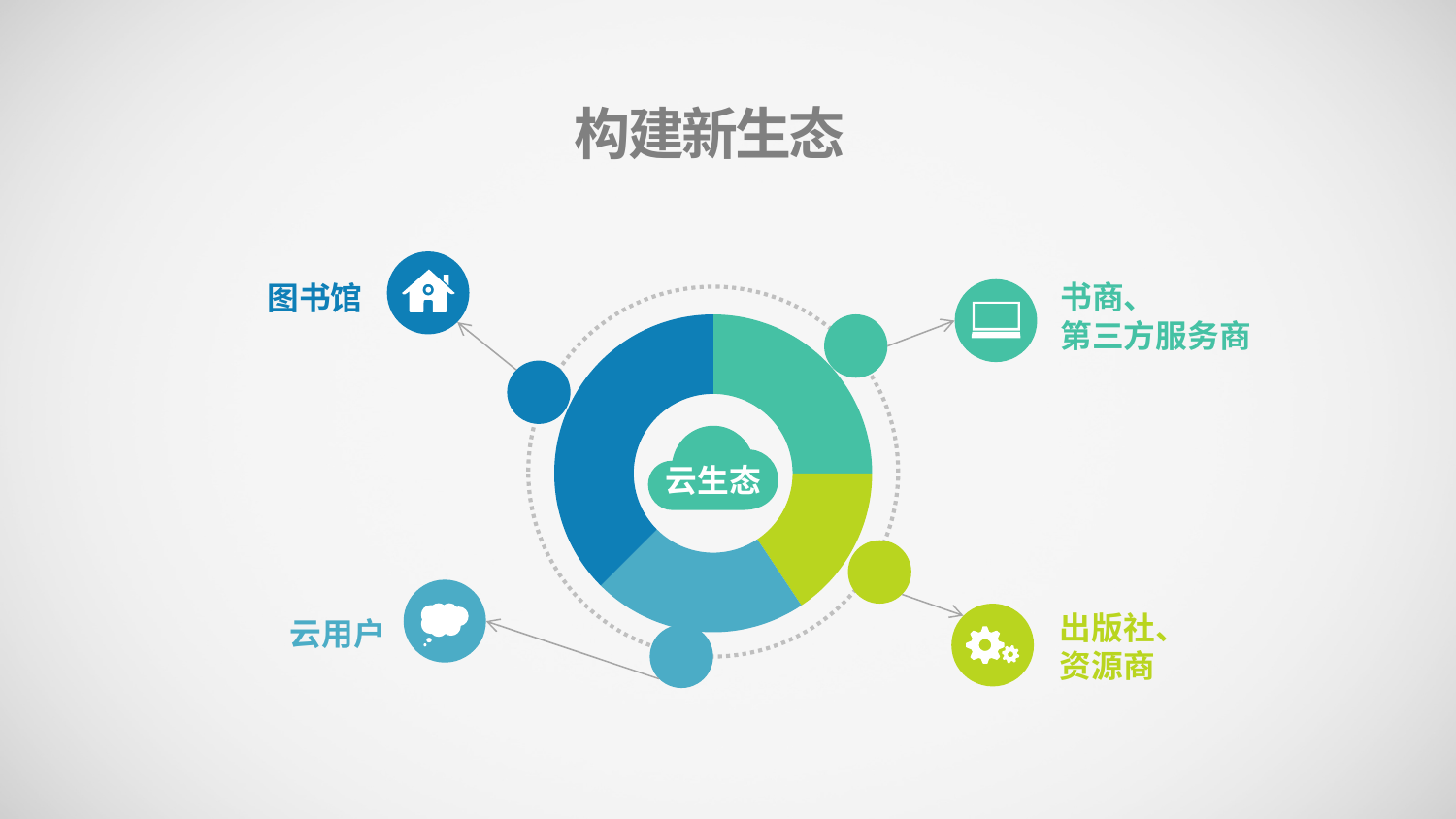
Which segment is larger, 书商、第三方服务商 or 出版社、资源商? 书商、第三方服务商 What is the title of the slide? 构建新生态 What label appears in the centre of the ring chart? 云生态 What kind of chart is shown in the centre of the slide? pie chart (donut) How many segments does the ring chart have? 4 Which segment is larger, 图书馆 or 出版社、资源商? 图书馆 Which segment of the ring chart is the largest? 图书馆